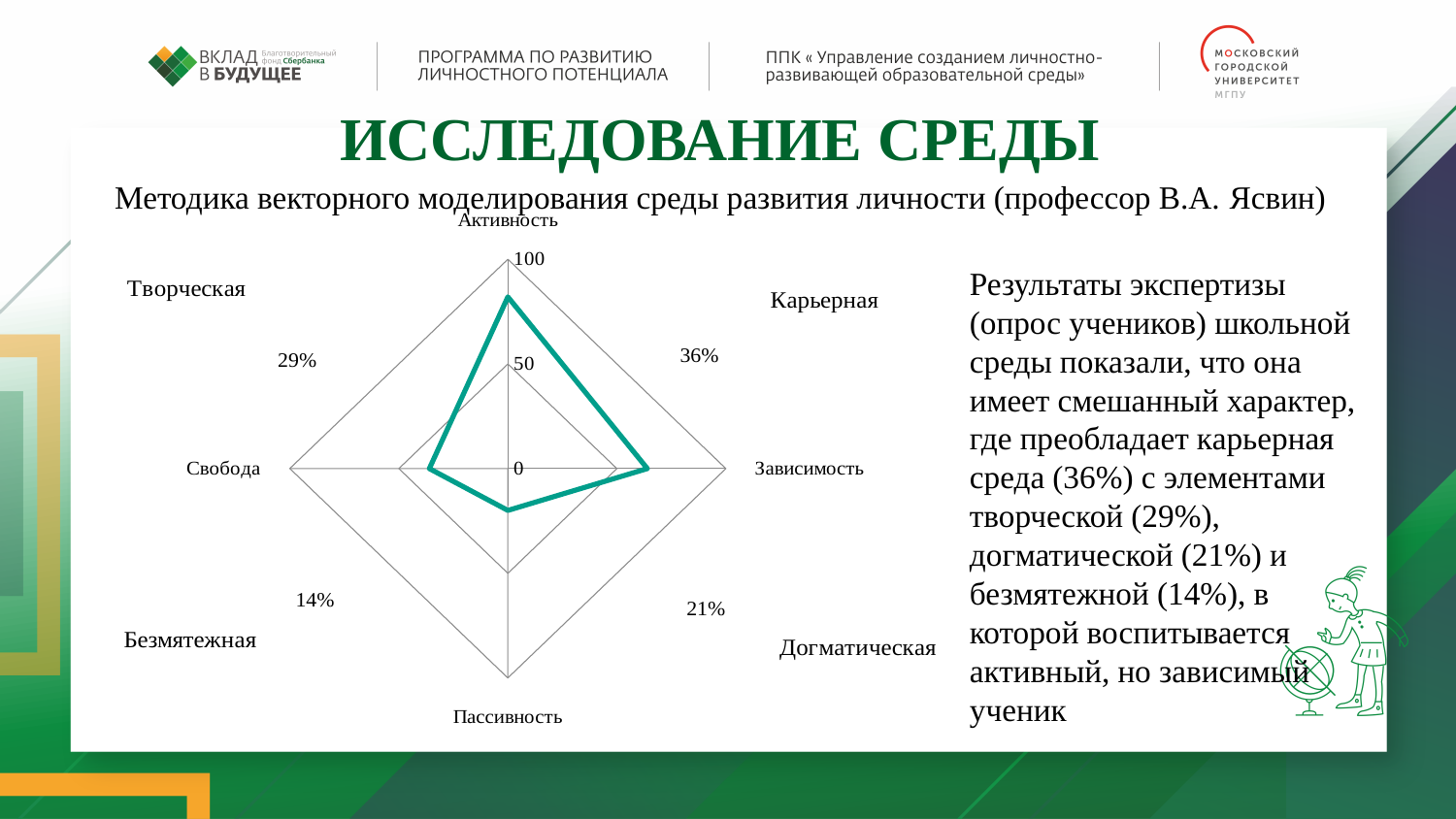
What is the difference between the percentages shown for Карьерная and Безмятежная? 22% What kind of chart is shown on the slide? radar chart Is the value for Пассивность greater or less than 50? less Which axis has the lowest value on the radar chart? Пассивность What percentage is shown for the Карьерная environment type? 36% What is the maximum value shown on the radar chart's axis scale? 100 Which axis has the highest value on the radar chart? Активность Is the value for Активность greater or less than 50? greater How many axes (categories) does the radar chart have? 4 Which is larger on the radar chart, the value for Активность or the value for Зависимость? Активность Is the value for Зависимость greater or less than 50? greater What percentage is shown for the Безмятежная environment type? 14%